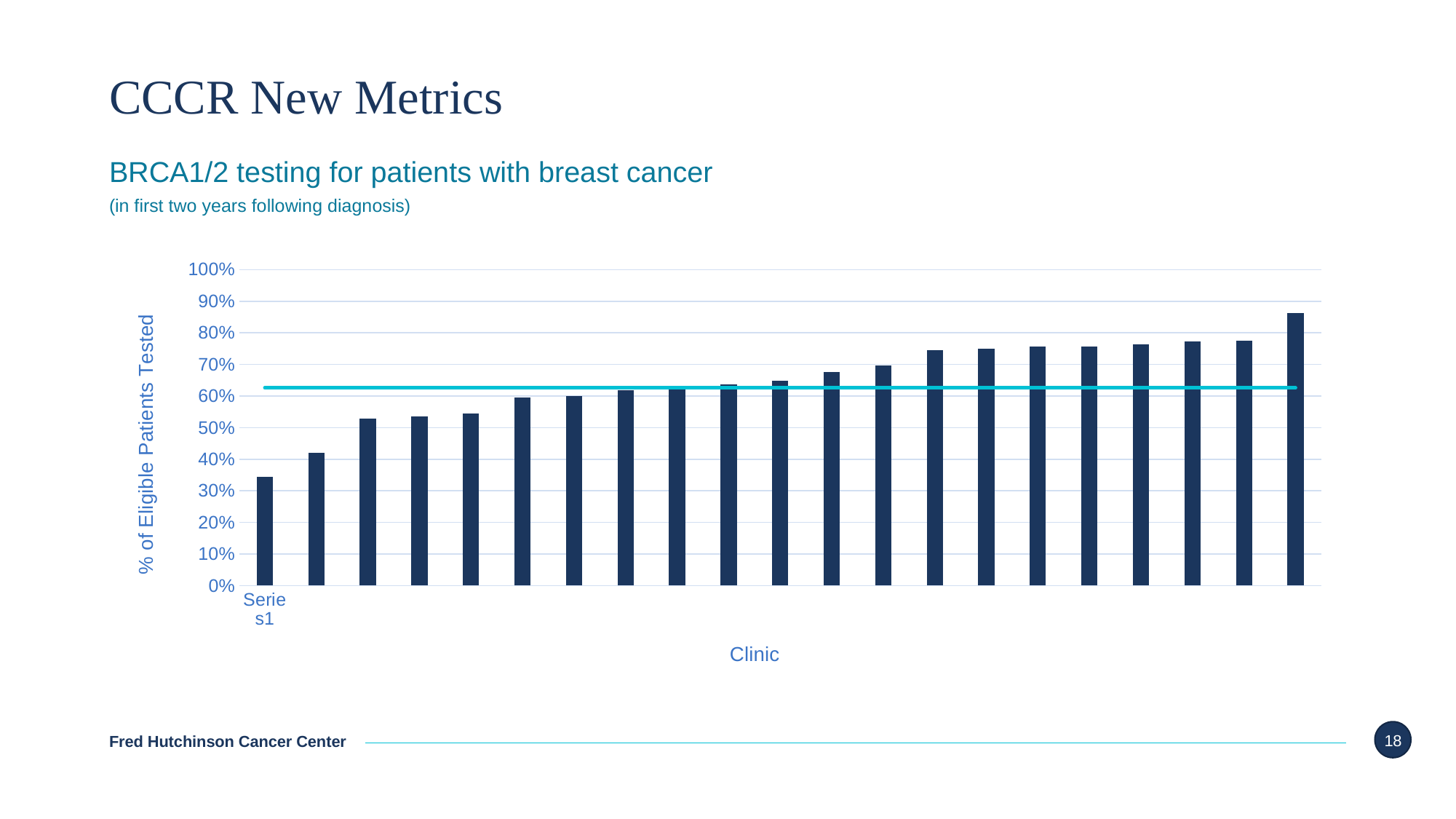
What is the label on the y axis of the chart? % of Eligible Patients Tested Which bar is the tallest in the chart? the rightmost bar Do the bar values rise or fall from left to right along the x axis? rise How many bars are plotted in the chart? 21 What is the label on the x axis of the chart? Clinic Is the value of the third bar from the right greater or less than 70%? greater What kind of chart is shown on the slide? combination bar and line chart Which is larger, the leftmost bar or the rightmost bar? the rightmost bar Is the value of the leftmost bar (Series1) greater or less than 40%? less Is the value of the rightmost bar greater or less than 80%? greater Which bar is the shortest in the chart? the leftmost bar (Series1)